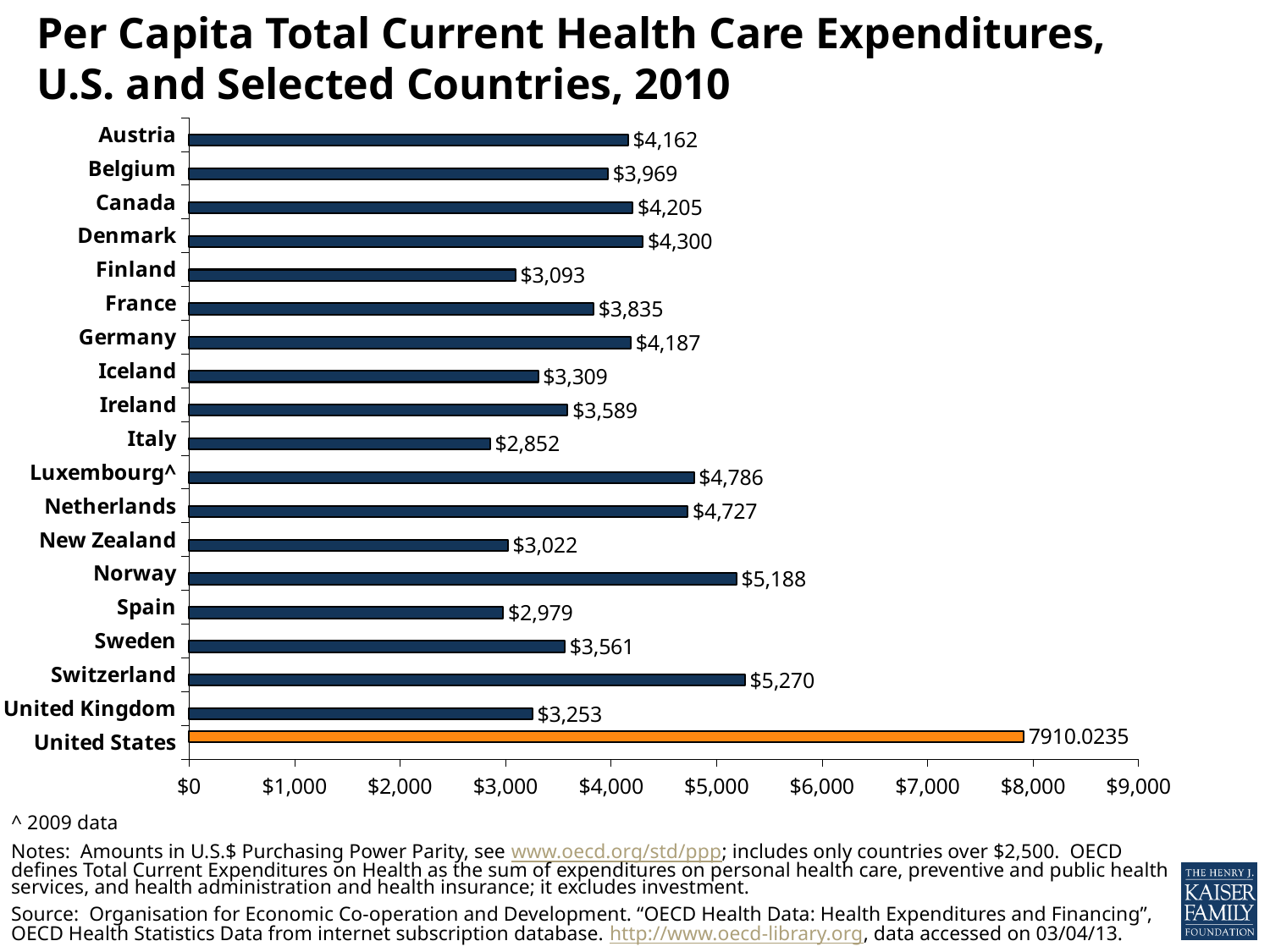
Is the value for Sweden greater or less than $4,000? less How many countries are shown on the chart? 19 What is the per capita health care expenditure shown for Norway? $5,188 Which country has the lowest per capita health care expenditure on the chart? Italy What value is labeled on the bar for the United States? 7910.0235 What is the difference between the values for Denmark and Canada? $95 Which country has the highest per capita health care expenditure on the chart? United States What value is labeled on the bar for Italy? $2,852 What is the difference between the values for Switzerland and Norway? $82 What kind of chart is shown on the slide? Bar chart Which has the larger value, Finland or France? France Which country's bar is colored orange instead of dark blue? United States